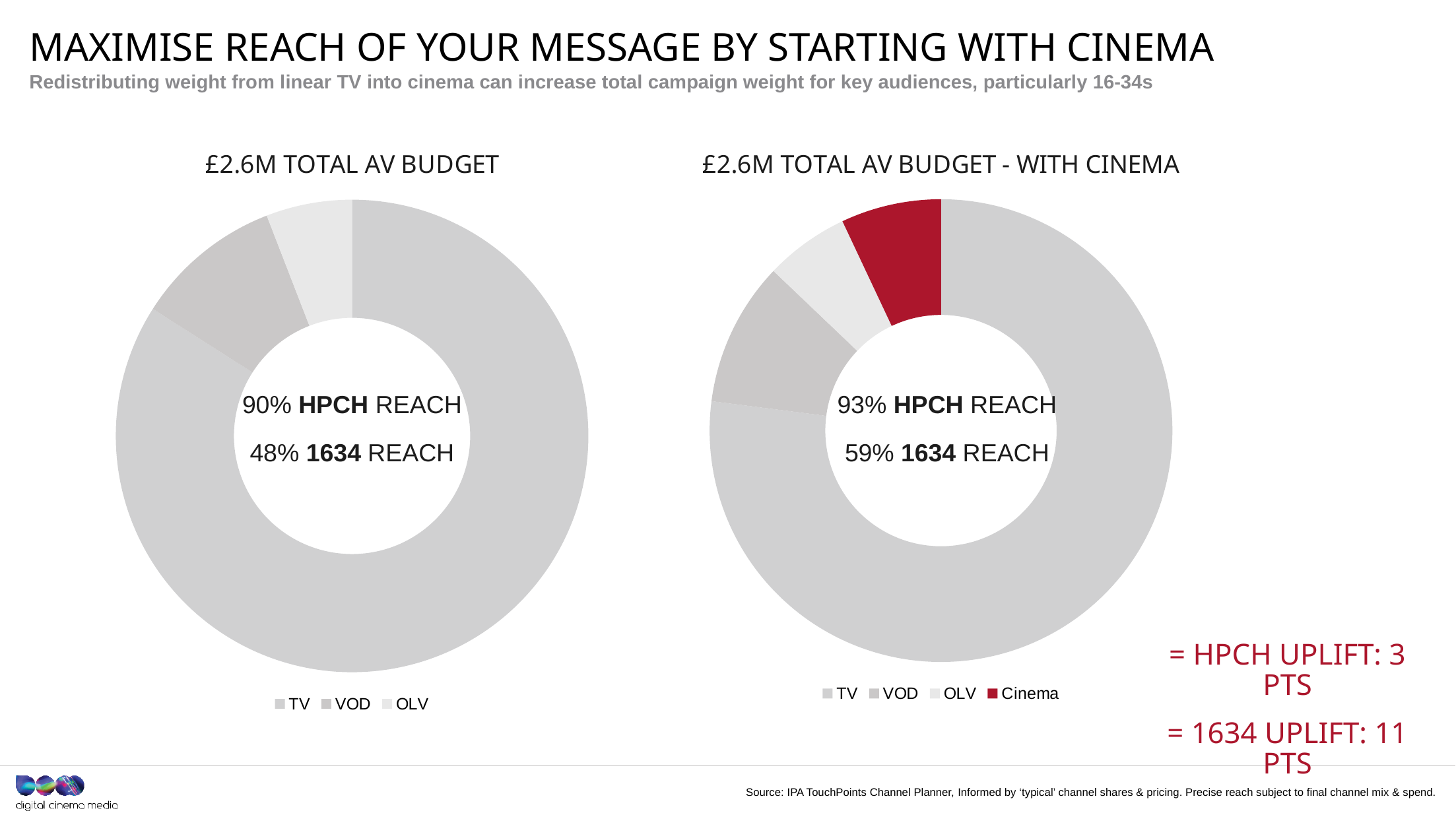
In the '£2.6M TOTAL AV BUDGET' chart on the left, how many categories does the legend list? 3 What is the difference in HPCH reach between the right chart (with cinema) and the left chart? 3 pts What HPCH reach is shown in the centre of the '£2.6M TOTAL AV BUDGET' chart on the left? 90% In the '£2.6M TOTAL AV BUDGET - WITH CINEMA' chart on the right, which slice is larger, TV or VOD? TV In the '£2.6M TOTAL AV BUDGET - WITH CINEMA' chart on the right, how many categories does the legend list? 4 What kind of chart is the '£2.6M TOTAL AV BUDGET' chart on the left? Pie chart (donut) In the '£2.6M TOTAL AV BUDGET' chart on the left, which category has the largest slice? TV What is the difference in 1634 reach between the right chart (with cinema) and the left chart? 11 pts In the '£2.6M TOTAL AV BUDGET - WITH CINEMA' chart on the right, which category has the largest slice? TV What 1634 reach is shown in the centre of the '£2.6M TOTAL AV BUDGET - WITH CINEMA' chart on the right? 59% Which legend entry appears only in the right-hand chart and not in the left-hand chart? Cinema In the '£2.6M TOTAL AV BUDGET' chart on the left, which category has the smallest slice? OLV